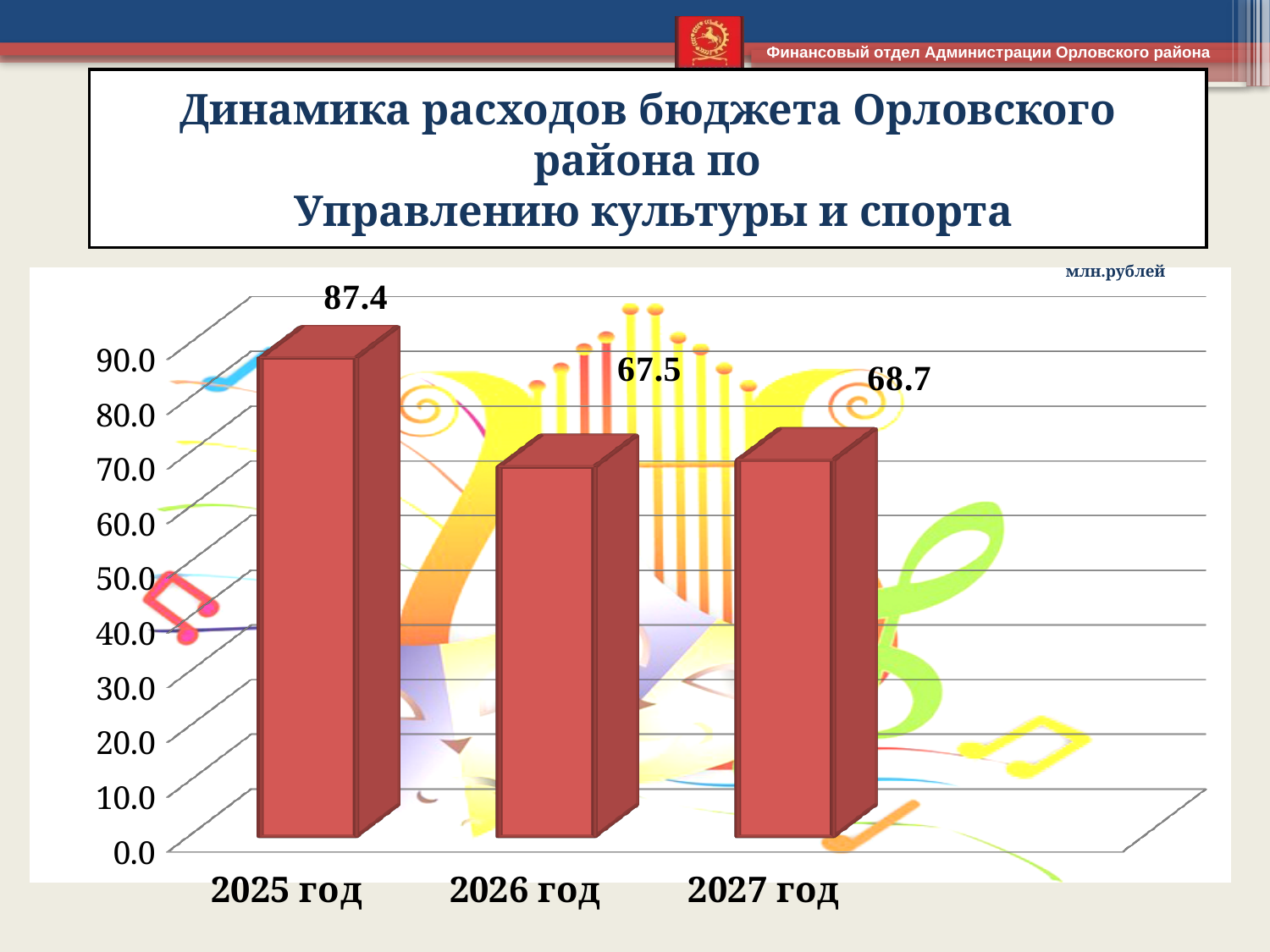
What is the difference between the values for 2027 год and 2026 год? 1.2 Is the value for 2026 год greater or less than 70.0? less Which year has the highest value? 2025 год Which is larger, the value for 2025 год or the value for 2027 год? 2025 год How many years are shown on the chart? 3 Which year has the lowest value? 2026 год What unit is indicated for the chart values? млн.рублей What is the value for 2026 год? 67.5 What is the difference between the values for 2025 год and 2026 год? 19.9 What kind of chart is shown on the slide? bar chart What is the value for 2027 год? 68.7 What is the value for 2025 год? 87.4